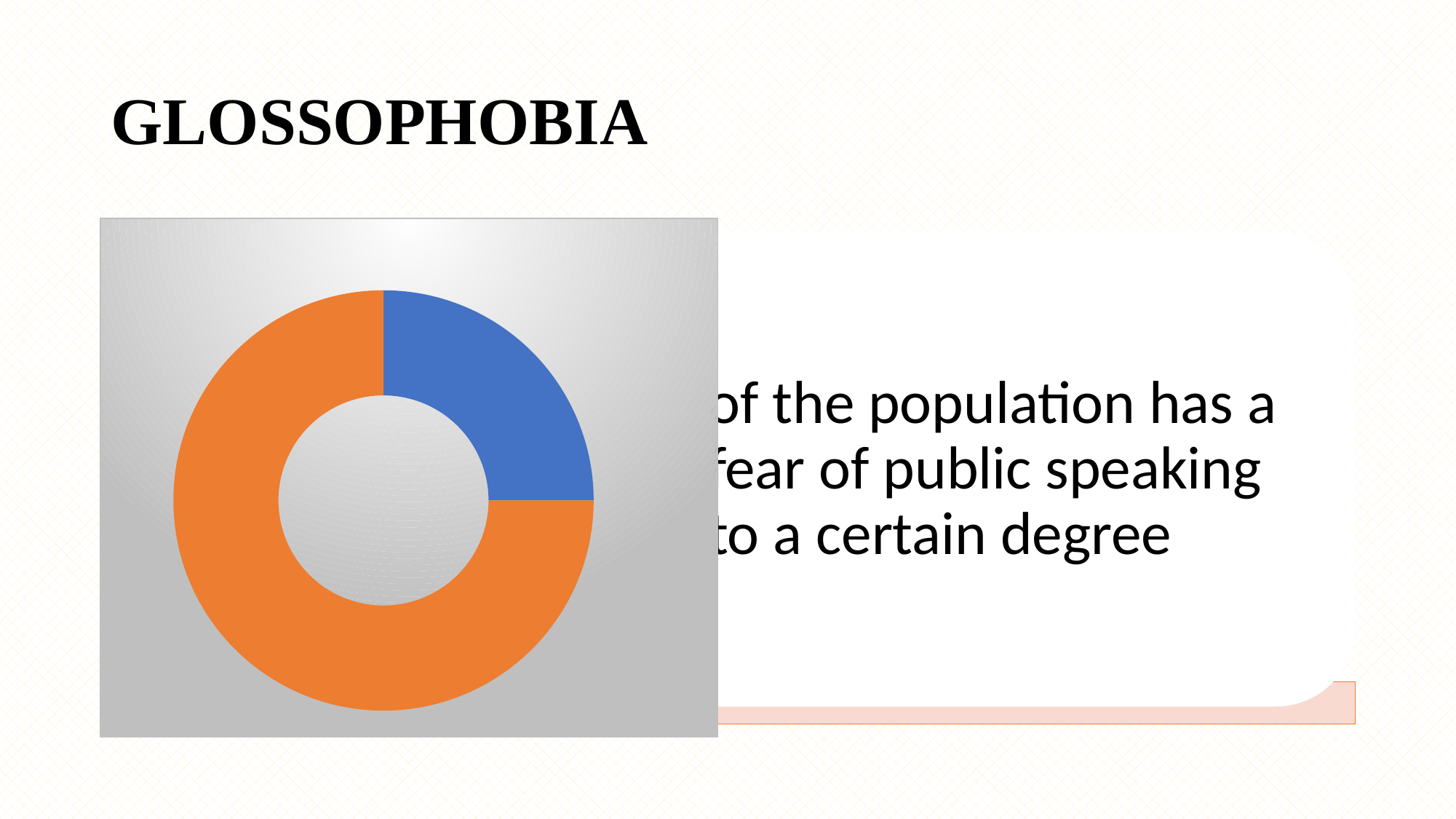
How many slices does the doughnut chart have? 2 Does the doughnut chart display a legend? No Which colour slice is the largest in the doughnut chart? orange Which colour slice is the smallest in the doughnut chart? blue Which slice of the doughnut chart is larger, the blue one or the orange one? orange What two colours are used for the slices of the doughnut chart? blue and orange What kind of chart is shown on the slide? doughnut chart